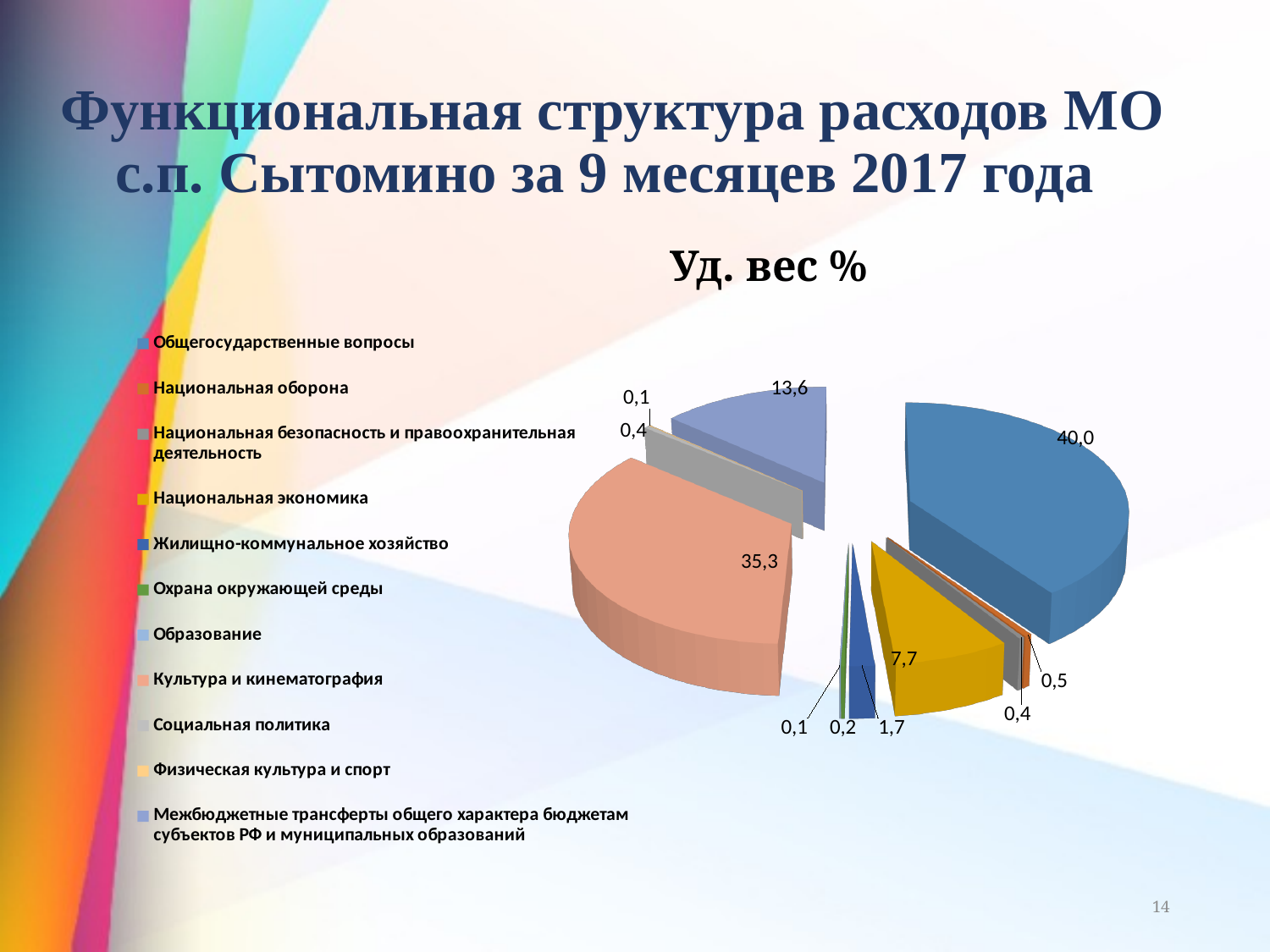
What is the value shown for Общегосударственные вопросы? 40,0 Which is larger: the value for Культура и кинематография or the value for Межбюджетные трансферты общего характера бюджетам субъектов РФ и муниципальных образований? Культура и кинематография What type of chart is shown on the slide? Pie chart What is the value shown for Культура и кинематография? 35,3 What is the title of the chart? Уд. вес % What is the difference between the values for Общегосударственные вопросы and Культура и кинематография? 4,7 Which is larger: the value for Национальная экономика or the value for Жилищно-коммунальное хозяйство? Национальная экономика What is the value shown for Межбюджетные трансферты общего характера бюджетам субъектов РФ и муниципальных образований? 13,6 What is the value shown for Национальная экономика? 7,7 Which category has the largest slice of the pie? Общегосударственные вопросы How many categories does the legend of the pie chart list? 11 What is the value shown for Жилищно-коммунальное хозяйство? 1,7